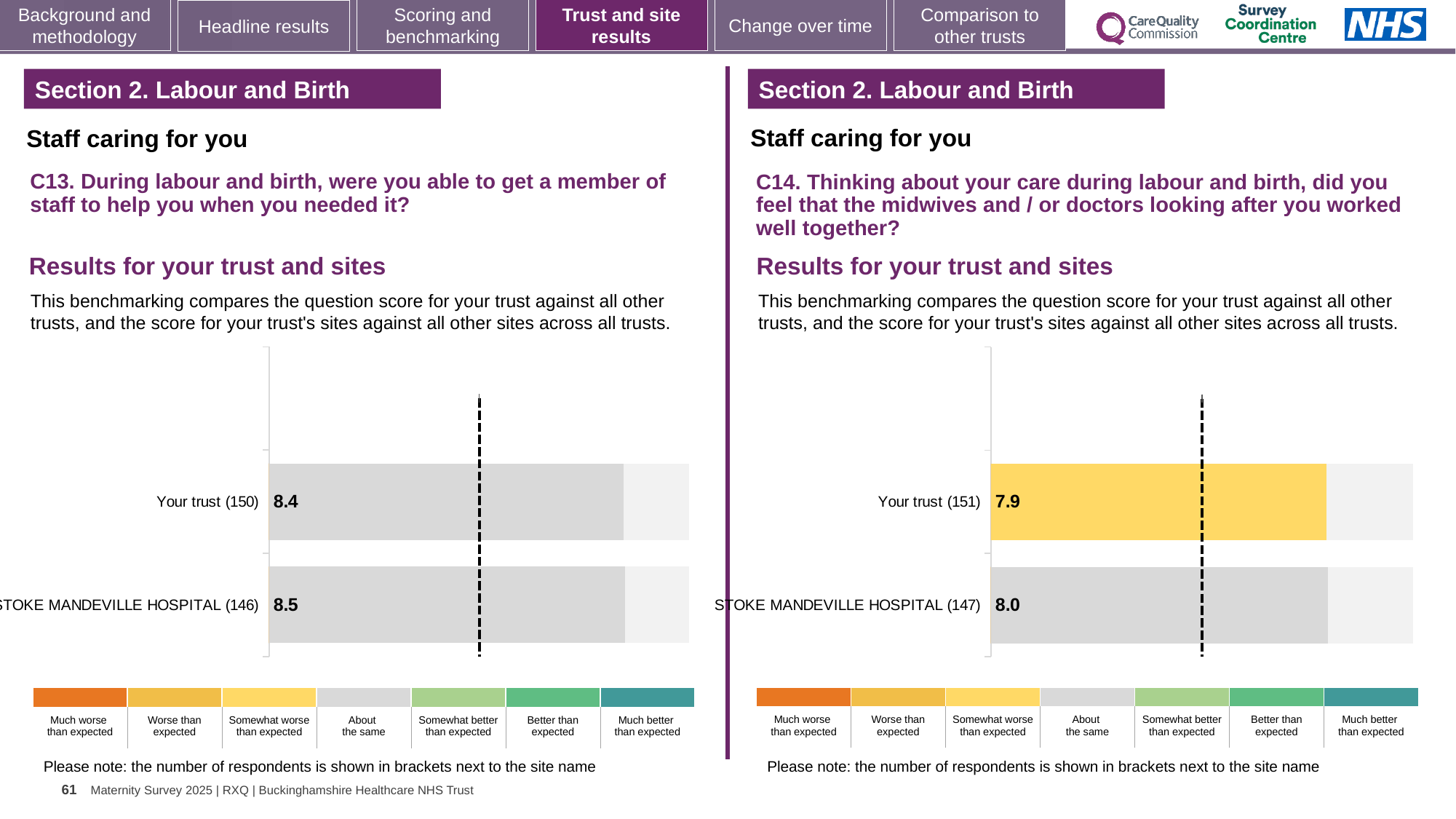
In the C14 chart on the right, how many respondents are shown in brackets for Your trust? 151 In the C14 chart on the right, what is the score for Stoke Mandeville Hospital? 8.0 In the C13 chart on the left, what is the score for Stoke Mandeville Hospital? 8.5 How many bars are plotted in the C13 chart on the left? 2 In the C14 chart on the right, what is the score for Your trust? 7.9 In the C14 chart on the right, which has the lower score, Your trust or Stoke Mandeville Hospital? Your trust In the C14 chart on the right, which benchmark category does the yellow colour of the Your trust bar correspond to in the legend? Somewhat worse than expected In the C13 chart on the left, which has the higher score, Your trust or Stoke Mandeville Hospital? Stoke Mandeville Hospital What type of chart is used in the C14 chart on the right? Bar chart In the C13 chart on the left, what is the difference between the Stoke Mandeville Hospital score and the Your trust score? 0.1 In the C13 chart on the left, what is the score for Your trust? 8.4 In the C14 chart on the right, what is the difference between the Stoke Mandeville Hospital score and the Your trust score? 0.1